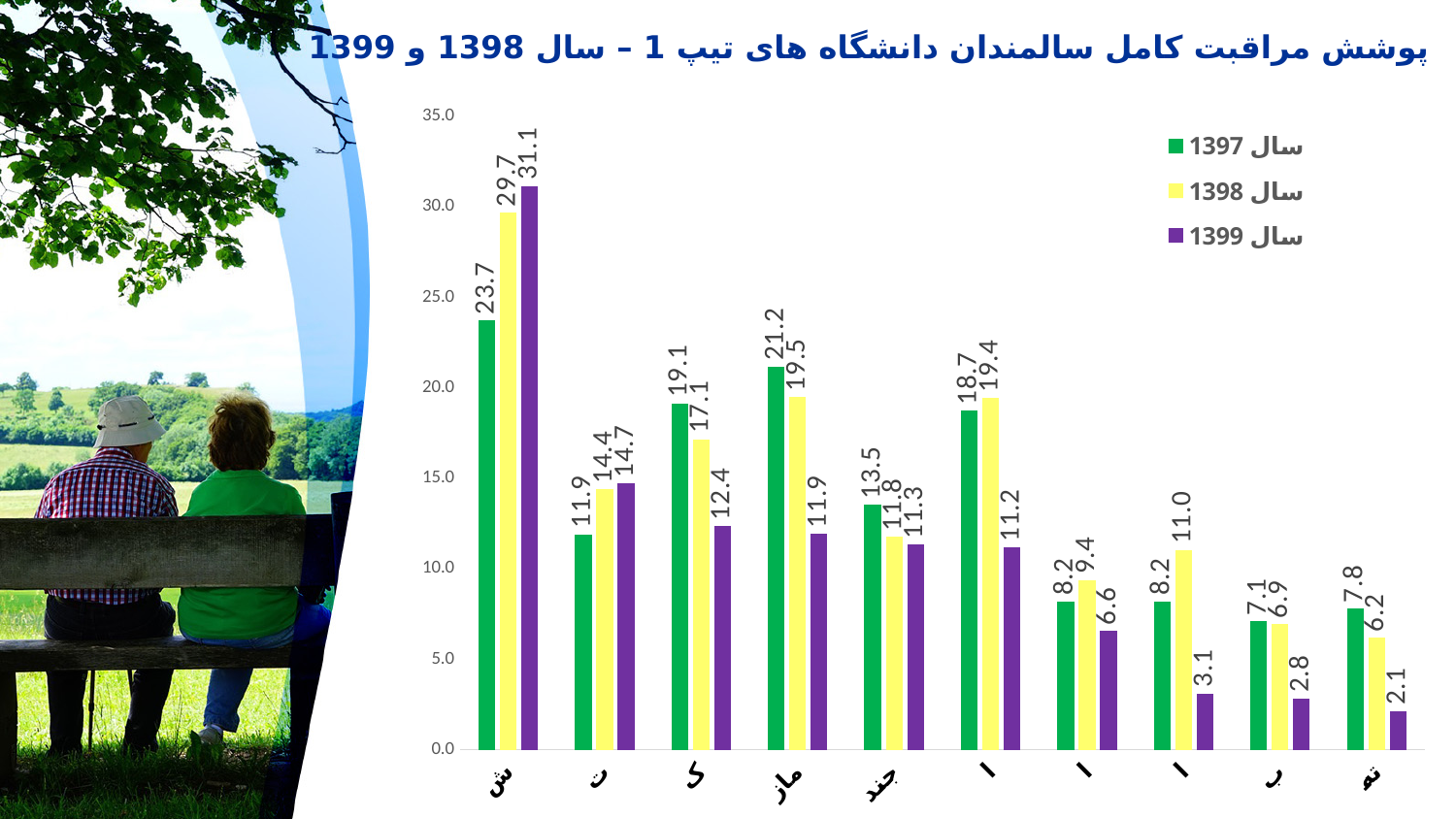
What is the value of the سال 1397 bar for the fourth category from the left? 21.2 What is the value of the سال 1399 bar for the rightmost category? 2.1 Do the سال 1399 values rise or fall from left to right along the x axis? fall What colour are the سال 1399 bars? purple For the third category from the left, which is larger: the سال 1397 value or the سال 1398 value? سال 1397 How many series does the legend list? 3 What kind of chart is shown on the slide? bar chart What is the highest value shown on the chart? 31.1 For the leftmost category, what is the difference between the سال 1399 value and the سال 1397 value? 7.4 What is the value of the سال 1398 bar for the leftmost category? 29.7 What is the lowest value shown on the chart? 2.1 How many categories are plotted along the x axis? 10